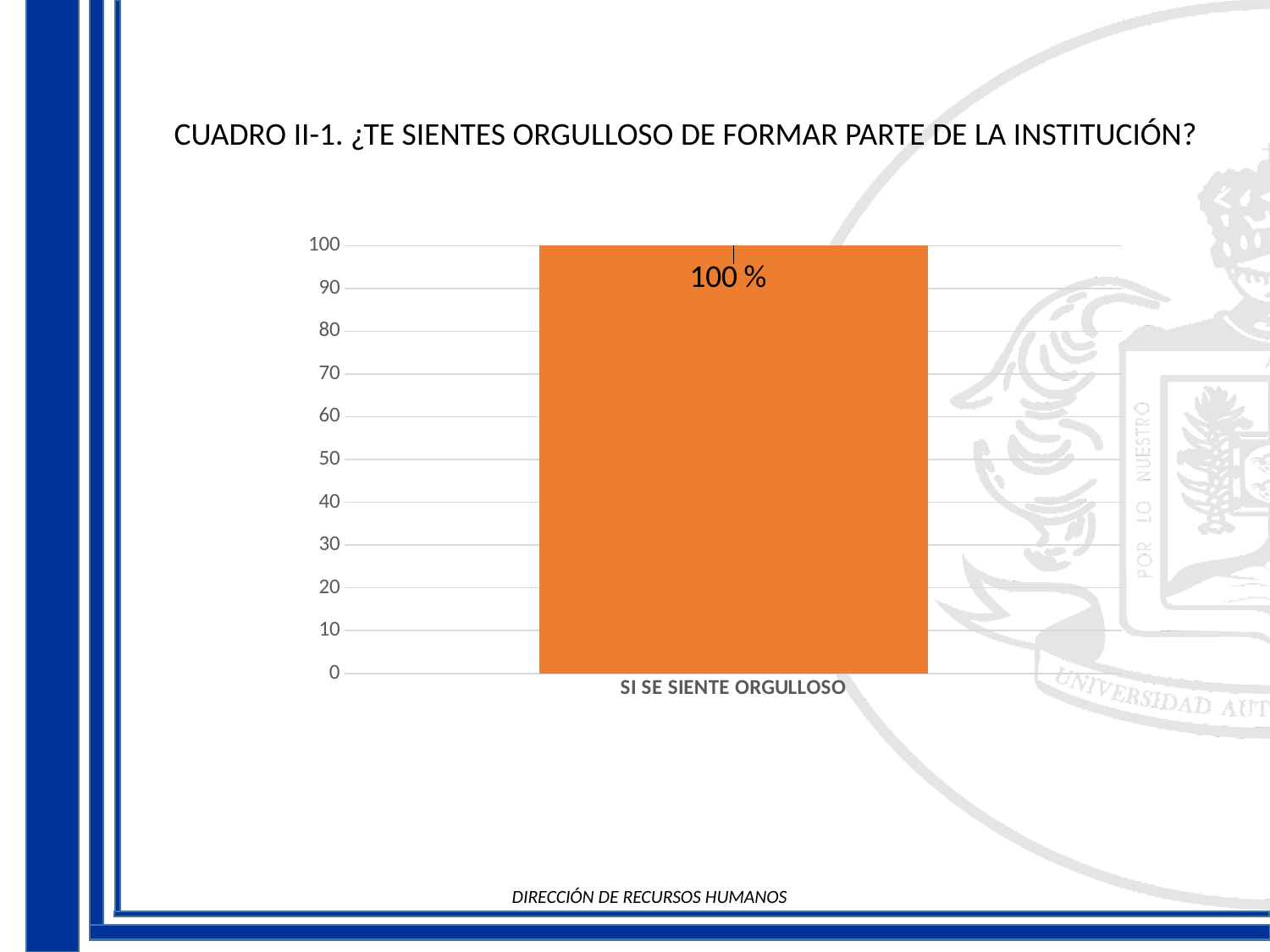
What is the label of the single category on the x axis? SI SE SIENTE ORGULLOSO What colour is the bar in the chart? orange Is the value for SI SE SIENTE ORGULLOSO greater or less than 50? greater What is the highest value shown on the vertical axis? 100 What kind of chart is shown on the slide? bar chart How many categories are plotted on the x axis? 1 What is the value shown for SI SE SIENTE ORGULLOSO? 100 %